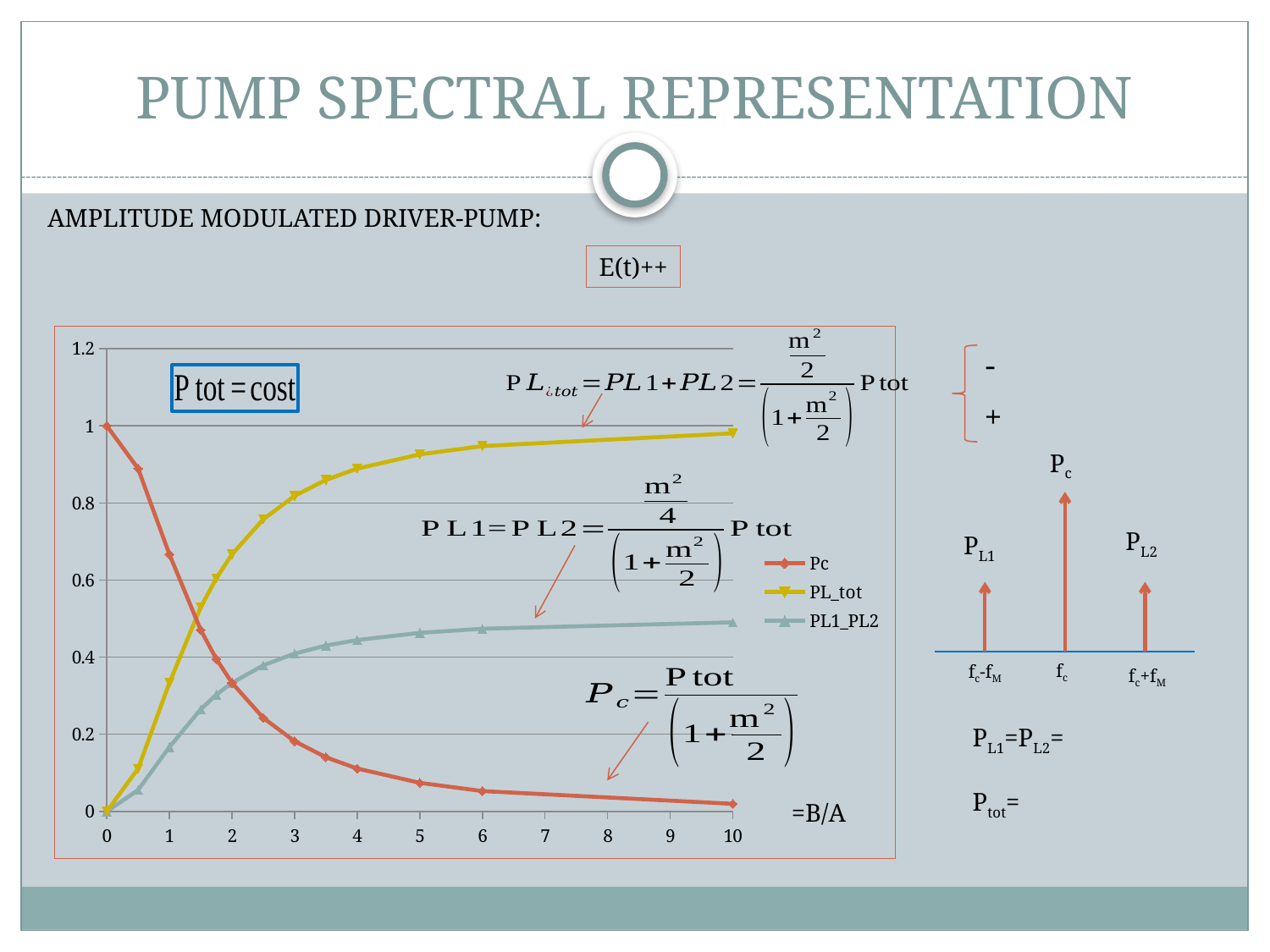
Is the value of the Pc series at x = 10 greater or less than 0.2? less What is the value of the Pc series at x = 0? 1 At x = 1, which is larger: the Pc series or the PL1_PL2 series? Pc Does the PL_tot series rise or fall as x increases from 0 to 10? rise Does the Pc series rise or fall as x increases from 0 to 10? fall What is the value of the PL_tot series at x = 0? 0 What kind of chart is shown on the slide? line chart Is the value of the PL1_PL2 series at x = 10 greater or less than 0.4? greater Is the value of the PL_tot series at x = 10 greater or less than 0.8? greater What are the three series named in the chart legend? Pc, PL_tot, PL1_PL2 At x = 10, which series has the highest value? PL_tot How many series does the chart legend list? 3